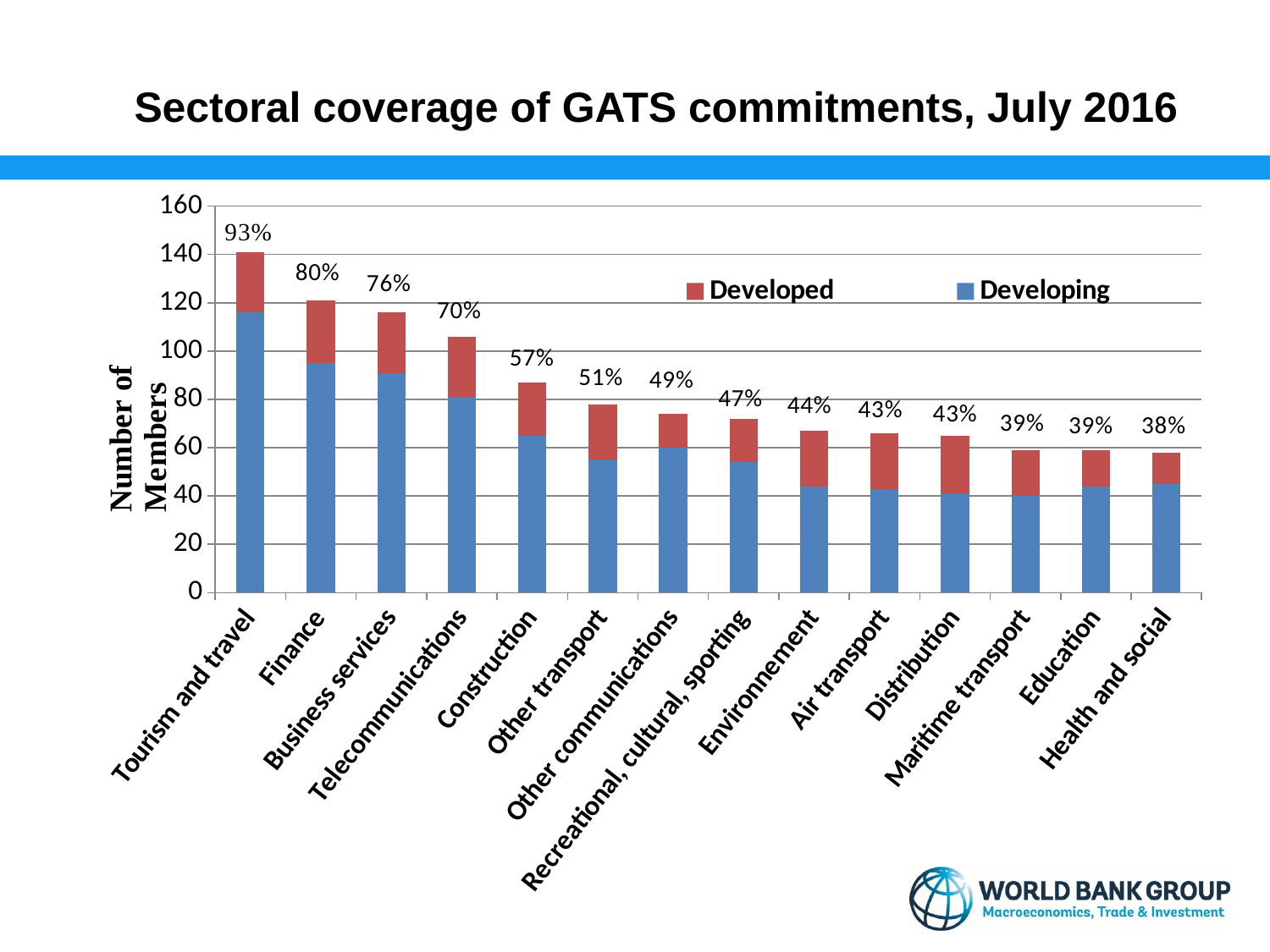
How many series does the legend list? 2 What is the percentage label shown above the bar for Health and social? 38% Which has a higher percentage label, Finance or Business services? Finance How many sectors are shown on the x axis? 14 What is the percentage label shown above the bar for Tourism and travel? 93% What is the difference between the percentage labels for Tourism and travel and Finance? 13% Which sector has the lowest percentage label? Health and social Which sector has the highest percentage label? Tourism and travel Is the total number of members for Telecommunications greater or less than 100? greater Is the total number of members for Business services greater or less than 120? less What is the percentage label shown above the bar for Construction? 57% What kind of chart is shown on the slide? bar chart